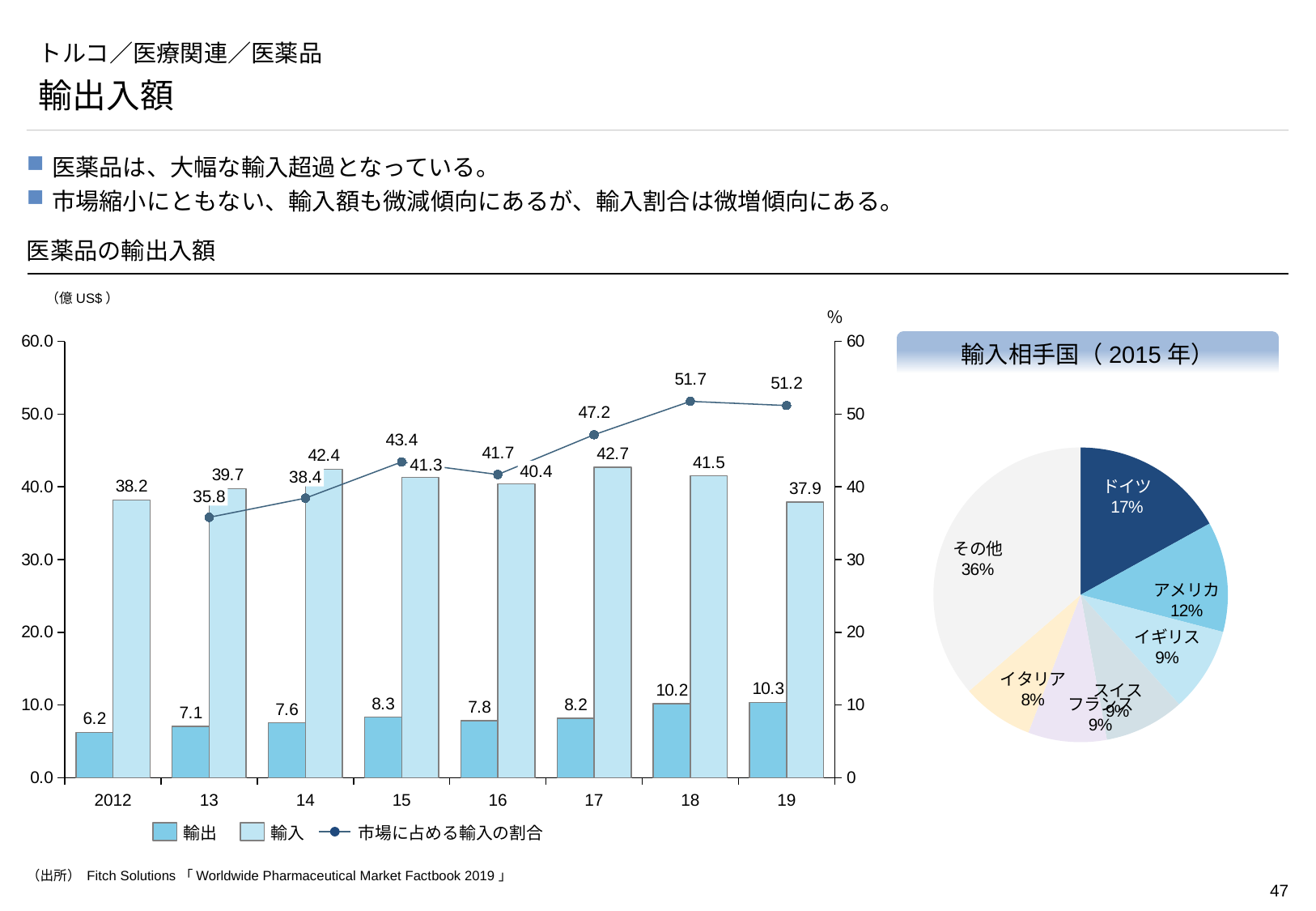
「輸入相手国（2015年）」の円グラフで、ドイツの割合は何%ですか？ 17% 「医薬品の輸出入額」のグラフで、2019年の輸出額はいくらですか？ 10.3 「医薬品の輸出入額」のグラフで、2012年の輸入額はいくらですか？ 38.2 「輸入相手国（2015年）」のグラフはどの種類のグラフですか？ 円グラフ 「医薬品の輸出入額」のグラフで、2018年の市場に占める輸入の割合は何%ですか？ 51.7 「医薬品の輸出入額」のグラフで、2014年の輸入額と輸出額の差はいくらですか？ 34.8 「医薬品の輸出入額」のグラフで、輸入額が最も高い年はどれですか？ 17 「医薬品の輸出入額」のグラフで、市場に占める輸入の割合は2013年から2018年にかけて全体として上昇していますか、下降していますか？ 上昇 「医薬品の輸出入額」のグラフで、2015年と2016年では、どちらの輸入額が大きいですか？ 2015 「医薬品の輸出入額」のグラフで、横軸には何年分のデータがありますか？ 8 「医薬品の輸出入額」のグラフで、凡例にはいくつの系列がありますか？ 3 「医薬品の輸出入額」のグラフで、輸出額が最も低い年はどれですか？ 2012